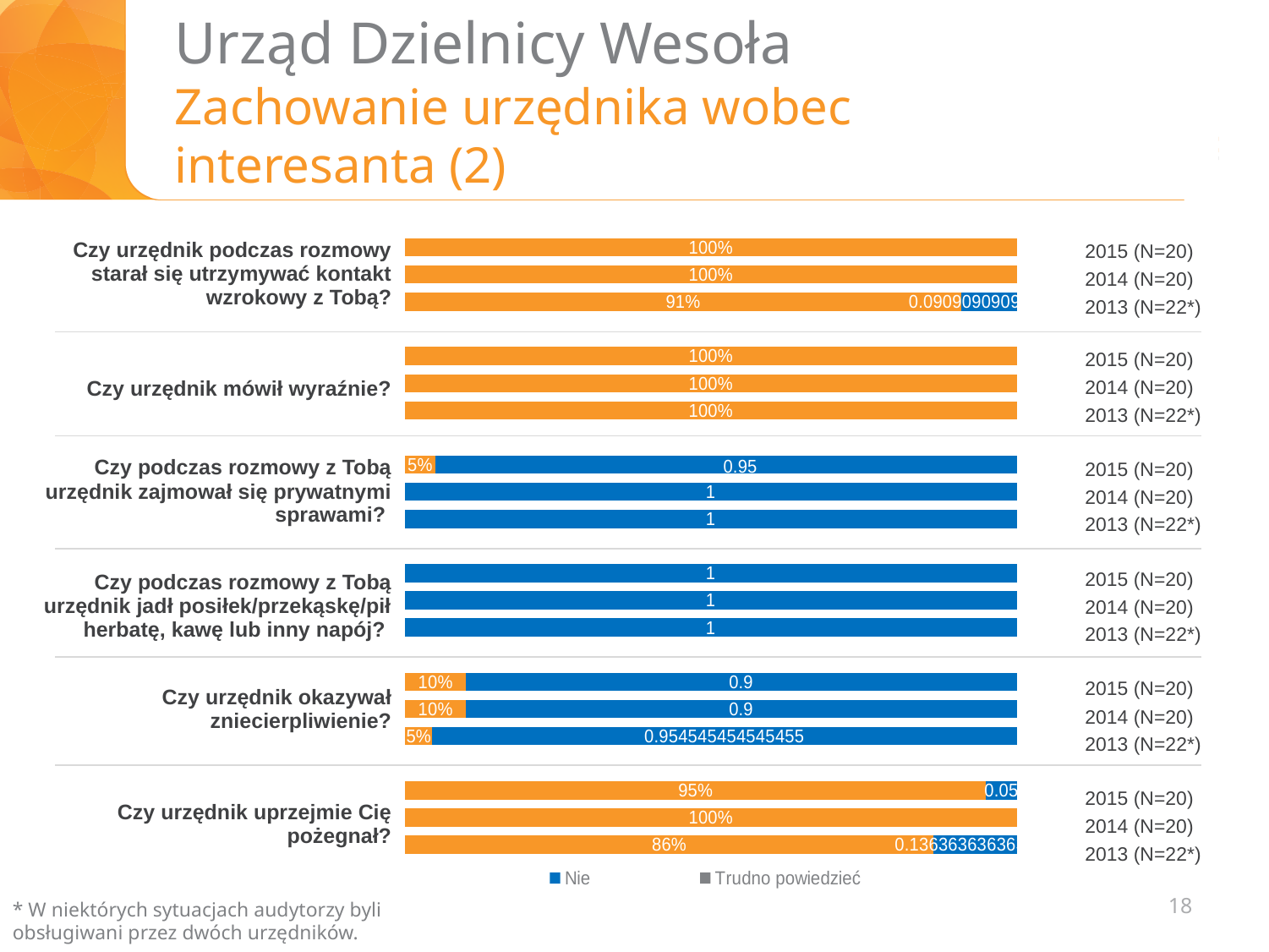
In the chart for "Czy urzędnik okazywał zniecierpliwienie?", what is the orange value for 2014 (N=20)? 10% In the chart for "Czy urzędnik mówił wyraźnie?", what value is shown for 2014 (N=20)? 100% In the chart for "Czy podczas rozmowy z Tobą urzędnik zajmował się prywatnymi sprawami?", what is the orange value for 2015 (N=20)? 5% In the chart for "Czy urzędnik podczas rozmowy starał się utrzymywać kontakt wzrokowy z Tobą?", what is the orange value for 2013 (N=22*)? 91% How many bars does the chart for "Czy urzędnik mówił wyraźnie?" contain? 3 In the chart for "Czy urzędnik uprzejmie Cię pożegnał?", which year has the larger orange value, 2015 (N=20) or 2013 (N=22*)? 2015 (N=20) In the chart for "Czy urzędnik okazywał zniecierpliwienie?", what is the blue value for 2015 (N=20)? 0.9 In the chart for "Czy urzędnik uprzejmie Cię pożegnał?", what is the blue value for 2015 (N=20)? 0.05 In the chart for "Czy urzędnik podczas rozmowy starał się utrzymywać kontakt wzrokowy z Tobą?", what is the orange value for 2015 (N=20)? 100% What kind of chart is used on this slide? Bar chart In the chart for "Czy podczas rozmowy z Tobą urzędnik zajmował się prywatnymi sprawami?", what is the blue value for 2015 (N=20)? 0.95 In the chart for "Czy urzędnik uprzejmie Cię pożegnał?", what is the orange value for 2013 (N=22*)? 86%